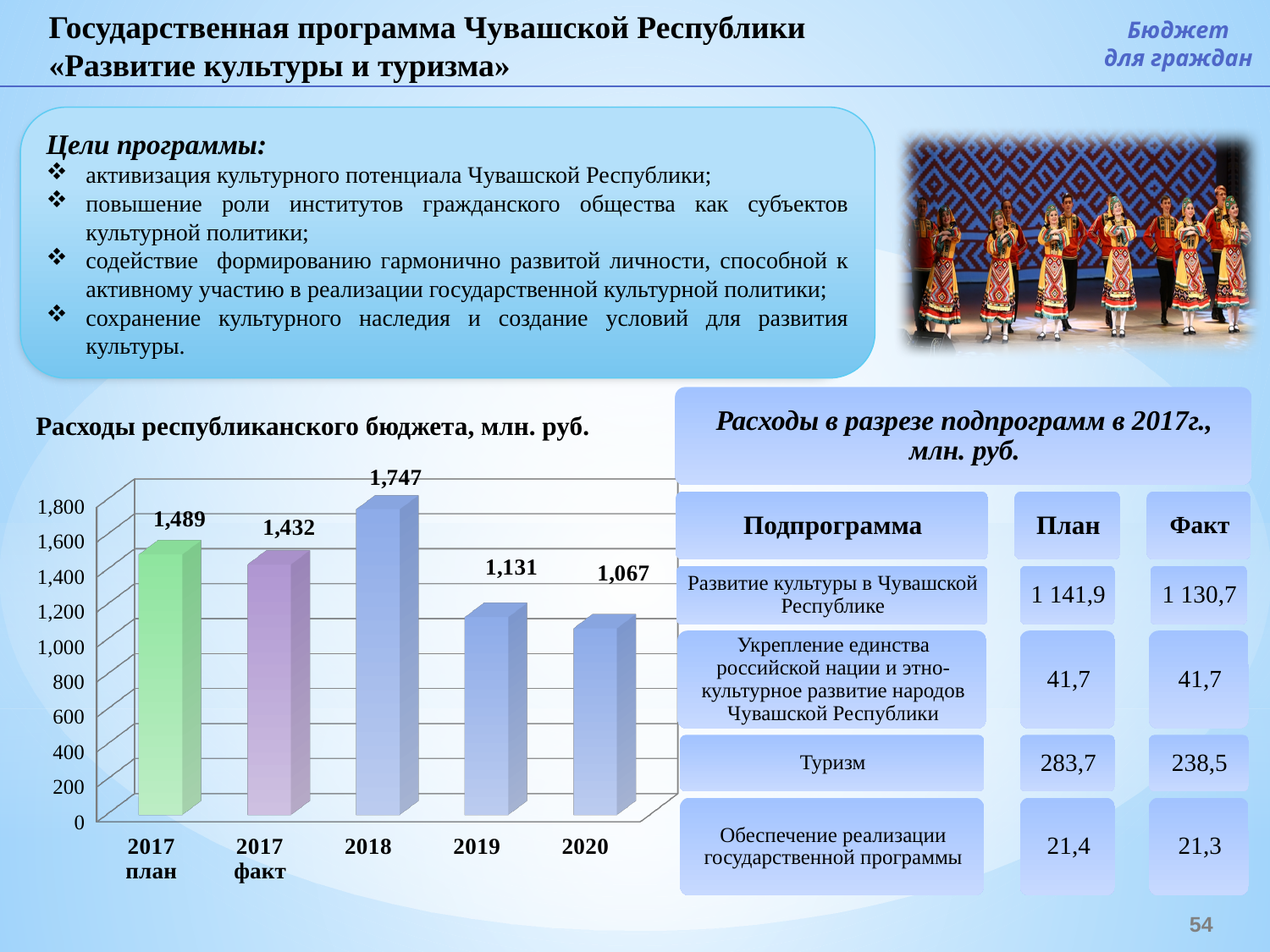
In the chart 'Расходы республиканского бюджета, млн. руб.', is the value for 2019 greater or less than 1,200? less In the chart 'Расходы республиканского бюджета, млн. руб.', what is the difference between the values for 2018 and 2019? 616 How many bars are shown in the chart 'Расходы республиканского бюджета, млн. руб.'? 5 In the chart 'Расходы республиканского бюджета, млн. руб.', which is larger: the value for 2019 or the value for 2020? 2019 What is the value for 2018 in the chart 'Расходы республиканского бюджета, млн. руб.'? 1,747 What type of chart is 'Расходы республиканского бюджета, млн. руб.'? bar chart Which category has the highest value in the chart 'Расходы республиканского бюджета, млн. руб.'? 2018 Which category has the lowest value in the chart 'Расходы республиканского бюджета, млн. руб.'? 2020 In the chart 'Расходы республиканского бюджета, млн. руб.', what is the difference between the values for '2017 план' and '2017 факт'? 57 What is the value for 2020 in the chart 'Расходы республиканского бюджета, млн. руб.'? 1,067 What is the value for '2017 план' in the chart 'Расходы республиканского бюджета, млн. руб.'? 1,489 What is the value for '2017 факт' in the chart 'Расходы республиканского бюджета, млн. руб.'? 1,432